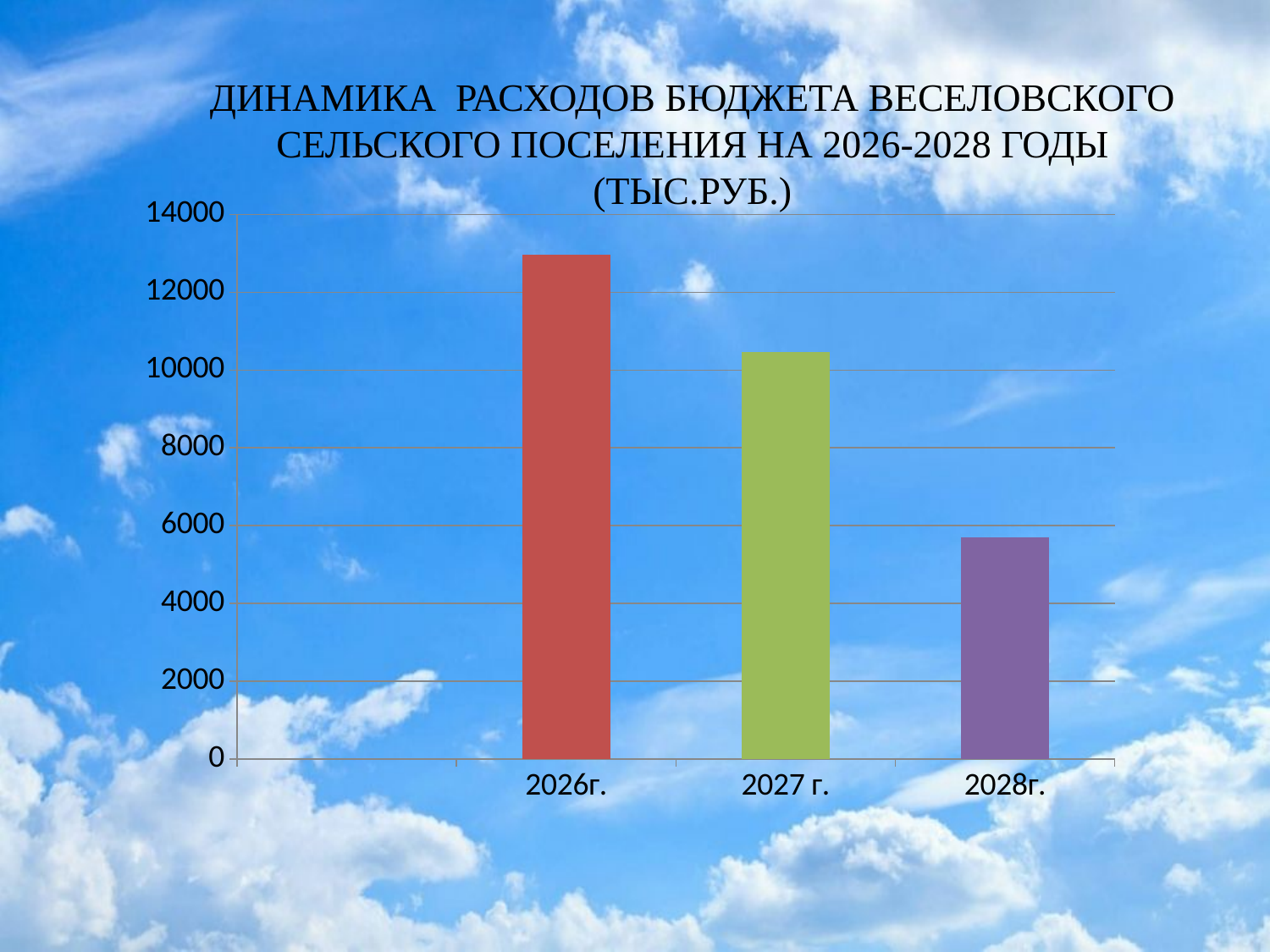
Is the value for 2026г. greater or less than 12000? greater Is the value for 2026г. greater or less than 14000? less Is the value for 2027 г. greater or less than 10000? greater Which year has the lowest budget expenditure? 2028г. What colour is the bar for 2027 г.? green What is the maximum value shown on the vertical axis? 14000 What kind of chart is shown on the slide? bar chart Which year has the highest budget expenditure? 2026г. Which is larger, the value for 2027 г. or the value for 2028г.? 2027 г. How many categories (years) are shown on the x axis? 3 Do the values rise or fall from 2026г. to 2028г.? fall